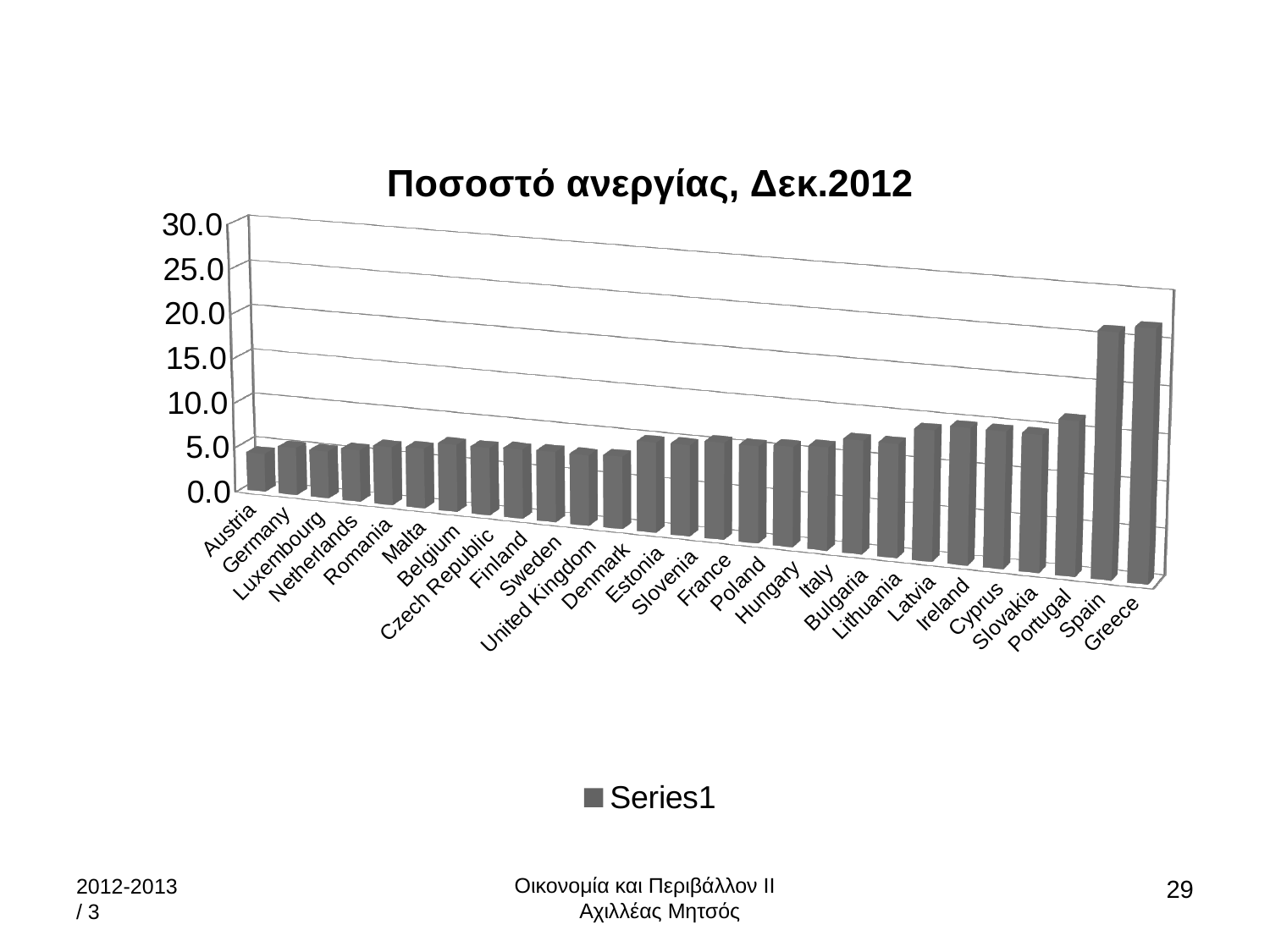
Do the values generally rise or fall moving from left to right along the x axis? rise Which has the larger value, Spain or Germany? Spain How many countries are shown on the x axis of the chart? 27 Is the value for Austria greater or less than 10.0? less What kind of chart is shown on the slide? bar chart Which has the larger value, Greece or Austria? Greece Is the value for Spain greater or less than 15.0? greater What is the name of the series shown in the legend? Series1 How many series does the legend list? 1 Is the value for Germany greater or less than 10.0? less What is the title of the chart? Ποσοστό ανεργίας, Δεκ.2012